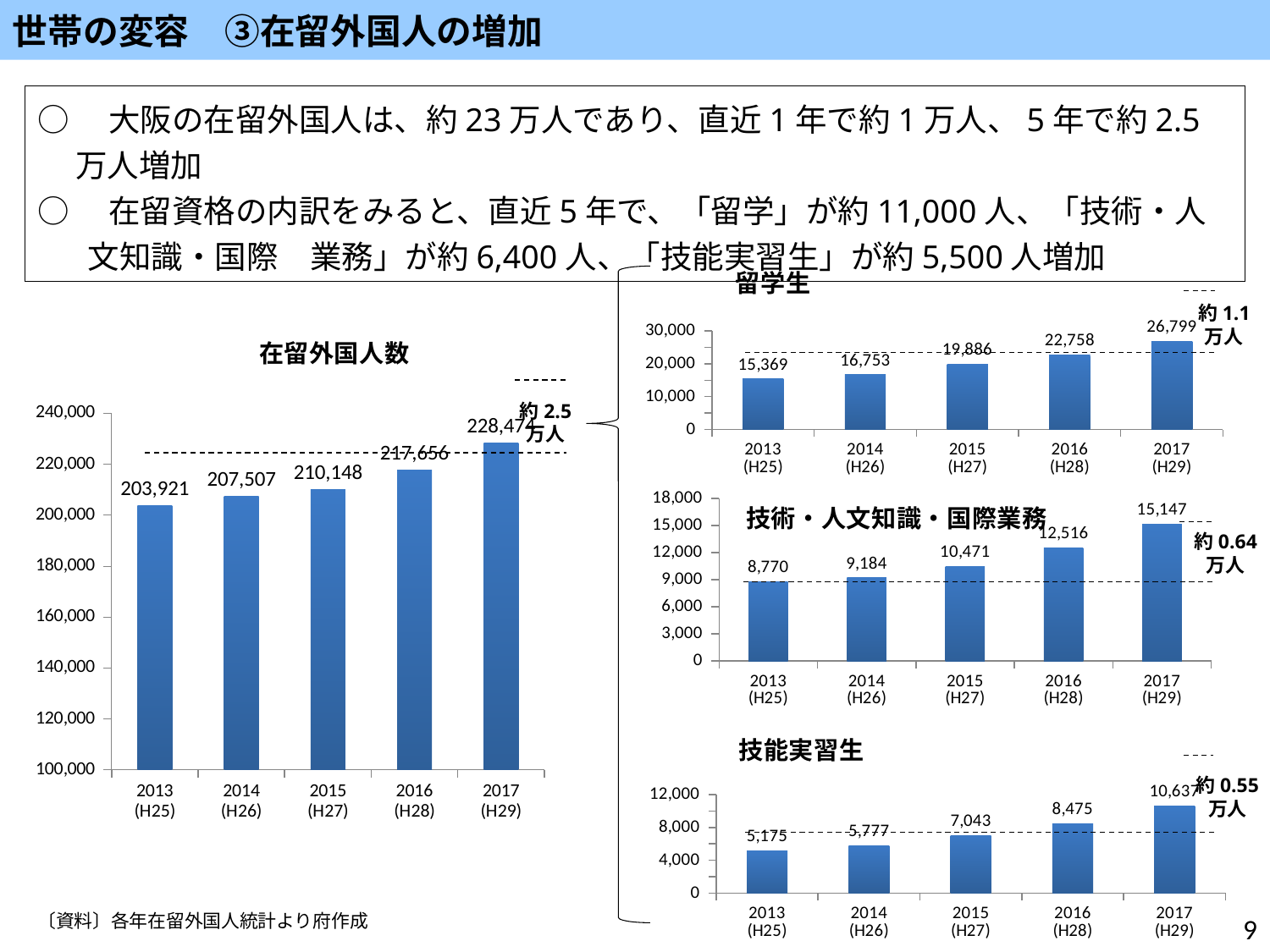
In the 在留外国人数 chart, what is the value for 2016 (H28)? 217,656 In the 技術・人文知識・国際業務 chart, what is the value for 2015 (H27)? 10,471 In the 留学生 chart, what is the value for 2017 (H29)? 26,799 How many years are plotted in the 技能実習生 chart? 5 In the 技術・人文知識・国際業務 chart, do the values rise or fall from 2013 to 2017? rise In the 在留外国人数 chart, what is the value for 2013 (H25)? 203,921 In the 留学生 chart, which year has the lowest value? 2013 (H25) In the 技能実習生 chart, what is the value for 2016 (H28)? 8,475 In the 在留外国人数 chart, is the value for 2017 (H29) greater or less than 220,000? greater In the 技能実習生 chart, which is larger, the value for 2014 (H26) or the value for 2015 (H27)? 2015 (H27) In the 留学生 chart, what is the difference between the 2017 (H29) and 2013 (H25) values? 11,430 In the 在留外国人数 chart, what is the difference between the 2015 (H27) and 2014 (H26) values? 2,641